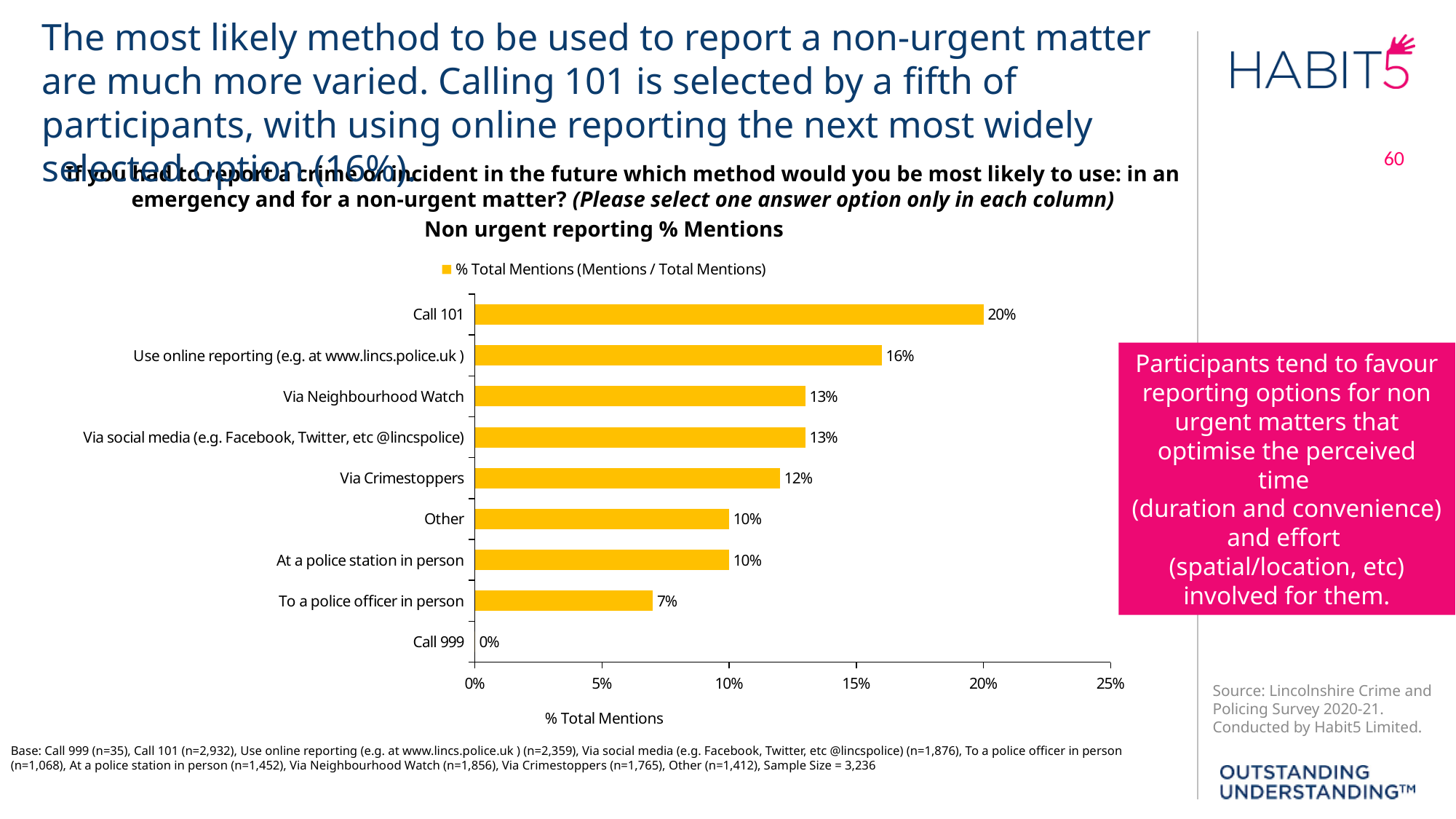
Which has a higher value: Via Crimestoppers or At a police station in person? Via Crimestoppers What is the label on the horizontal axis of the chart? % Total Mentions Which reporting method has the highest percentage of total mentions? Call 101 How many series does the legend list? 1 What colour are the bars in the chart? Yellow Which reporting method has the lowest percentage of total mentions? Call 999 What is the value shown for Via Crimestoppers? 12% What is the difference in percentage points between Call 101 and Use online reporting? 4% What percentage of total mentions does Call 101 receive for non-urgent reporting? 20% What is the value shown for To a police officer in person? 7% How many reporting methods are shown on the chart? 9 What type of chart is shown on the slide? Bar chart